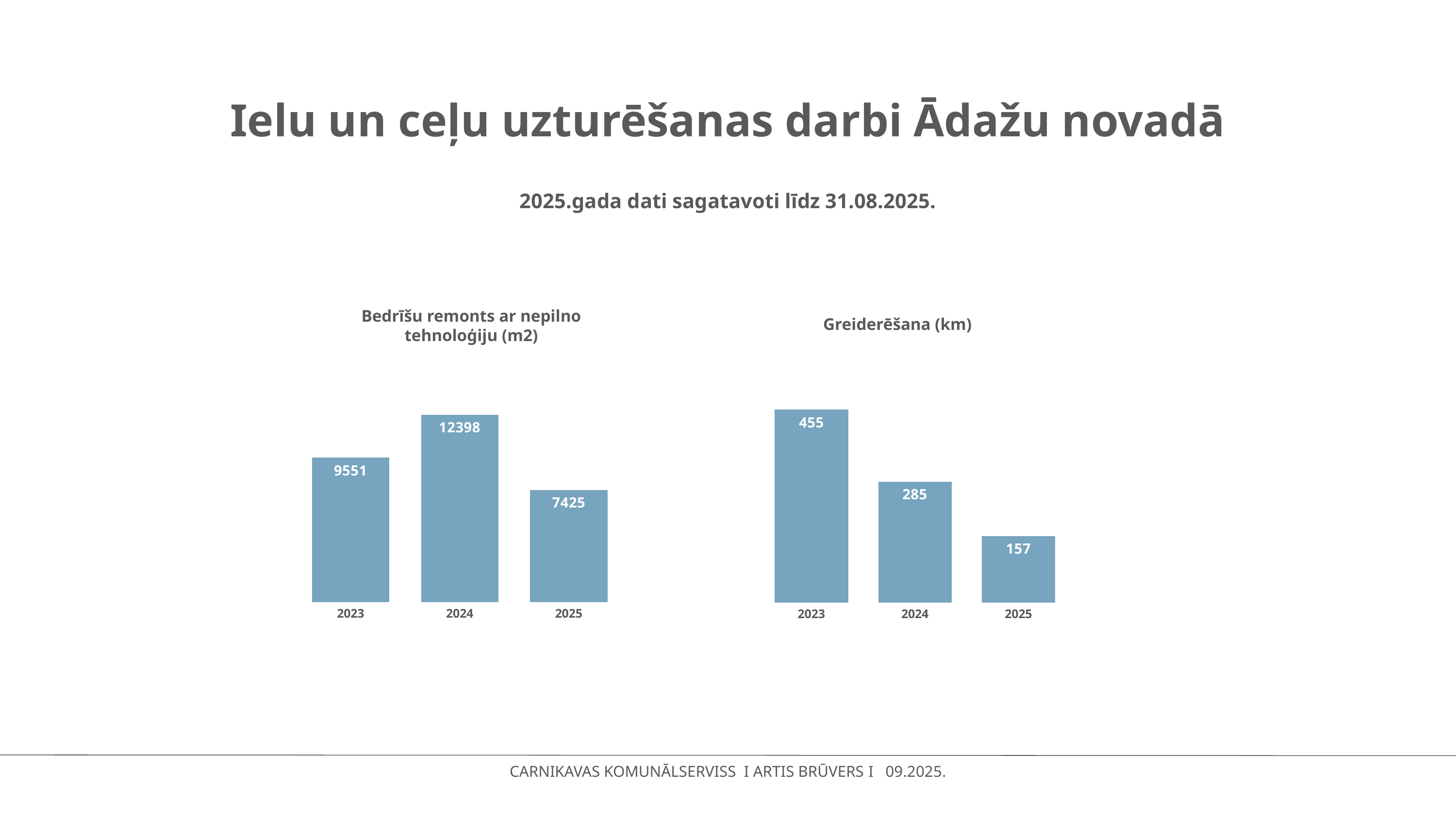
In the chart titled "Bedrīšu remonts ar nepilno tehnoloģiju (m2)", what is the difference between the 2024 and 2023 values? 2847 How many bars are in the chart titled "Greiderēšana (km)"? 3 In the chart titled "Bedrīšu remonts ar nepilno tehnoloģiju (m2)", which is larger, the value for 2023 or the value for 2025? 2023 In the chart titled "Bedrīšu remonts ar nepilno tehnoloģiju (m2)", what is the value for 2024? 12398 In the chart titled "Greiderēšana (km)", what is the value for 2024? 285 In the chart titled "Greiderēšana (km)", which year has the lowest value? 2025 In the chart titled "Greiderēšana (km)", do the values rise or fall from 2023 to 2025? Fall In the chart titled "Greiderēšana (km)", what is the difference between the 2023 and 2025 values? 298 In the chart titled "Greiderēšana (km)", what is the value for 2023? 455 In the chart titled "Bedrīšu remonts ar nepilno tehnoloģiju (m2)", which year has the highest value? 2024 What kind of chart is the chart titled "Greiderēšana (km)"? Bar chart In the chart titled "Bedrīšu remonts ar nepilno tehnoloģiju (m2)", what is the value for 2025? 7425